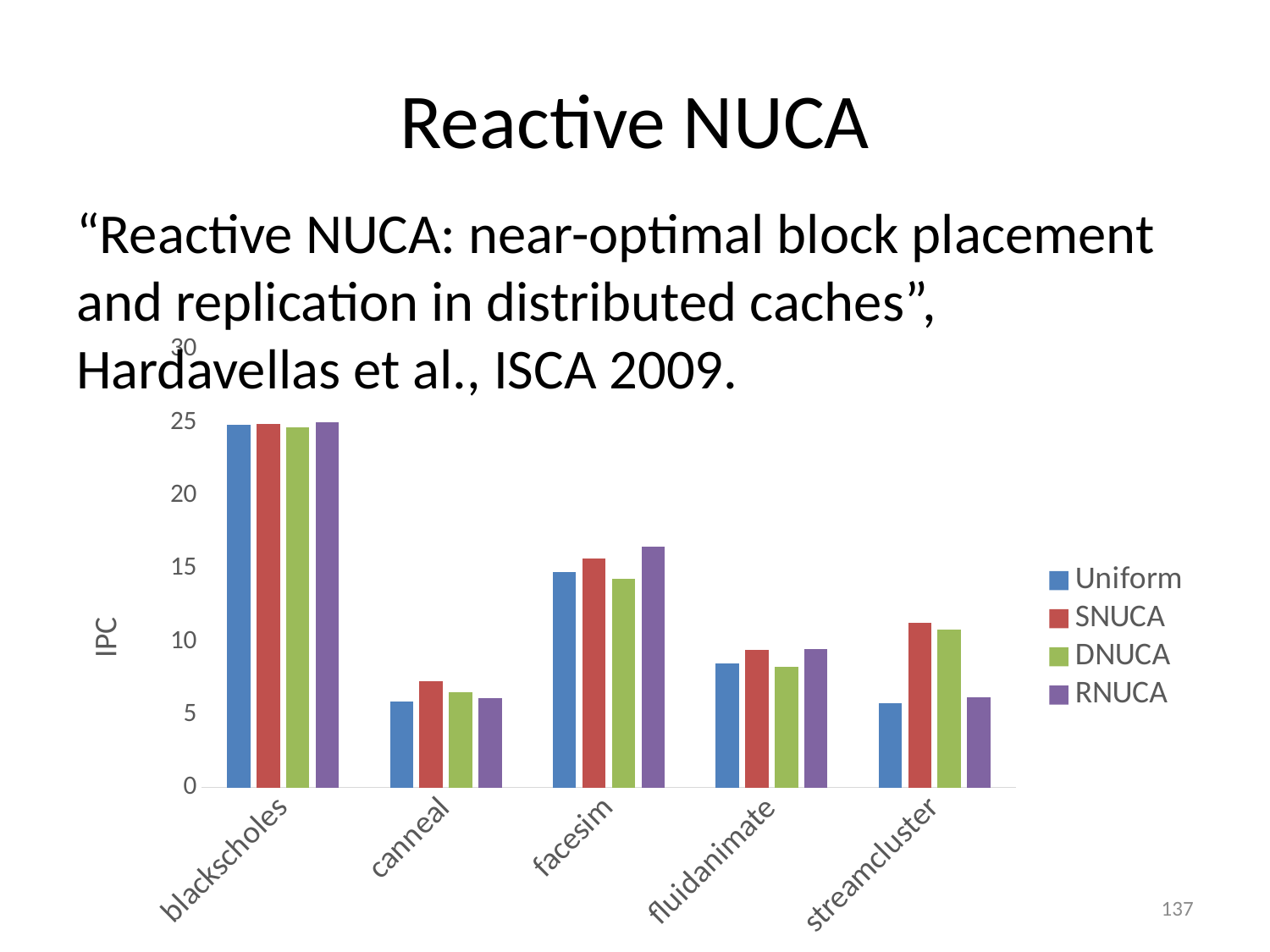
Is the RNUCA IPC value for fluidanimate greater or less than 10? less Is the SNUCA IPC value for streamcluster greater or less than 10? greater For canneal, which series has the highest IPC? SNUCA How many benchmark categories are shown on the x axis of the chart? 5 For facesim, which series has the highest IPC? RNUCA How many series does the chart's legend list? 4 For streamcluster, which is larger: the SNUCA value or the RNUCA value? SNUCA Which benchmark has the highest IPC values in the chart? blackscholes What is the label on the y axis of the chart? IPC Is the RNUCA IPC value for blackscholes greater or less than 20? greater What kind of chart is shown on the slide? bar chart